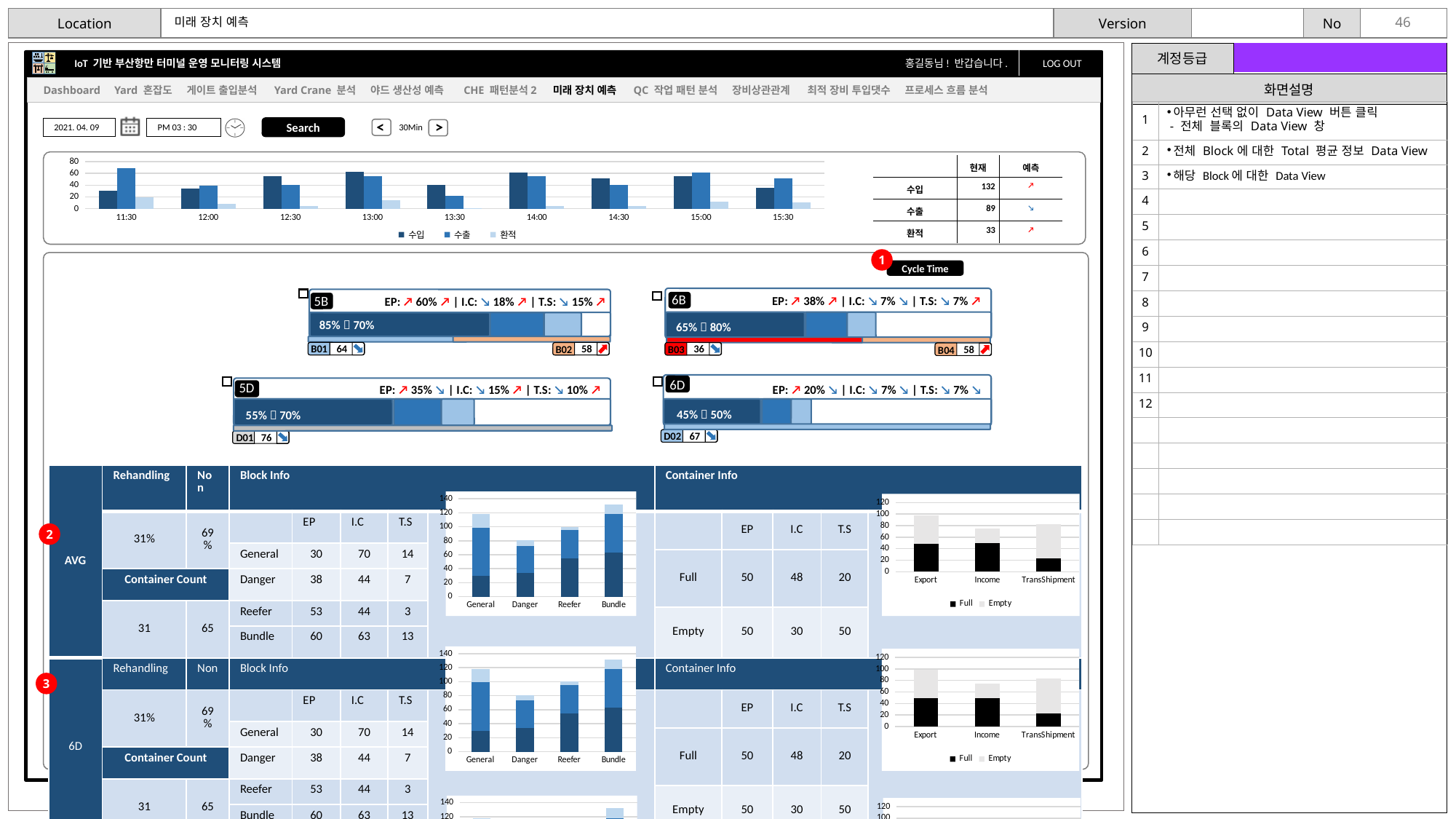
How many series does the legend of the top chart list? 3 In the top chart, is the 수입 value at 11:30 greater or less than 60? less In the Block Info chart in the AVG row, which category has the shortest stacked bar? Danger In the top chart, which series is shown in the lightest colour in the legend? 환적 How many series does the legend of the Container Info chart in the AVG row list? 2 In the Container Info chart in the AVG row, which category has the tallest stacked bar? Export How many time categories are shown on the x axis of the top chart? 9 In the Block Info chart in the AVG row, is the total stacked bar for Danger greater or less than 100? less In the Block Info chart in the AVG row, which category has the tallest stacked bar? Bundle How many categories are on the x axis of the Block Info chart in the AVG row? 4 In the top chart, is the 환적 value at 11:30 greater or less than 40? less What kind of chart is the chart at the top of the slide with time categories from 11:30 to 15:30? bar chart